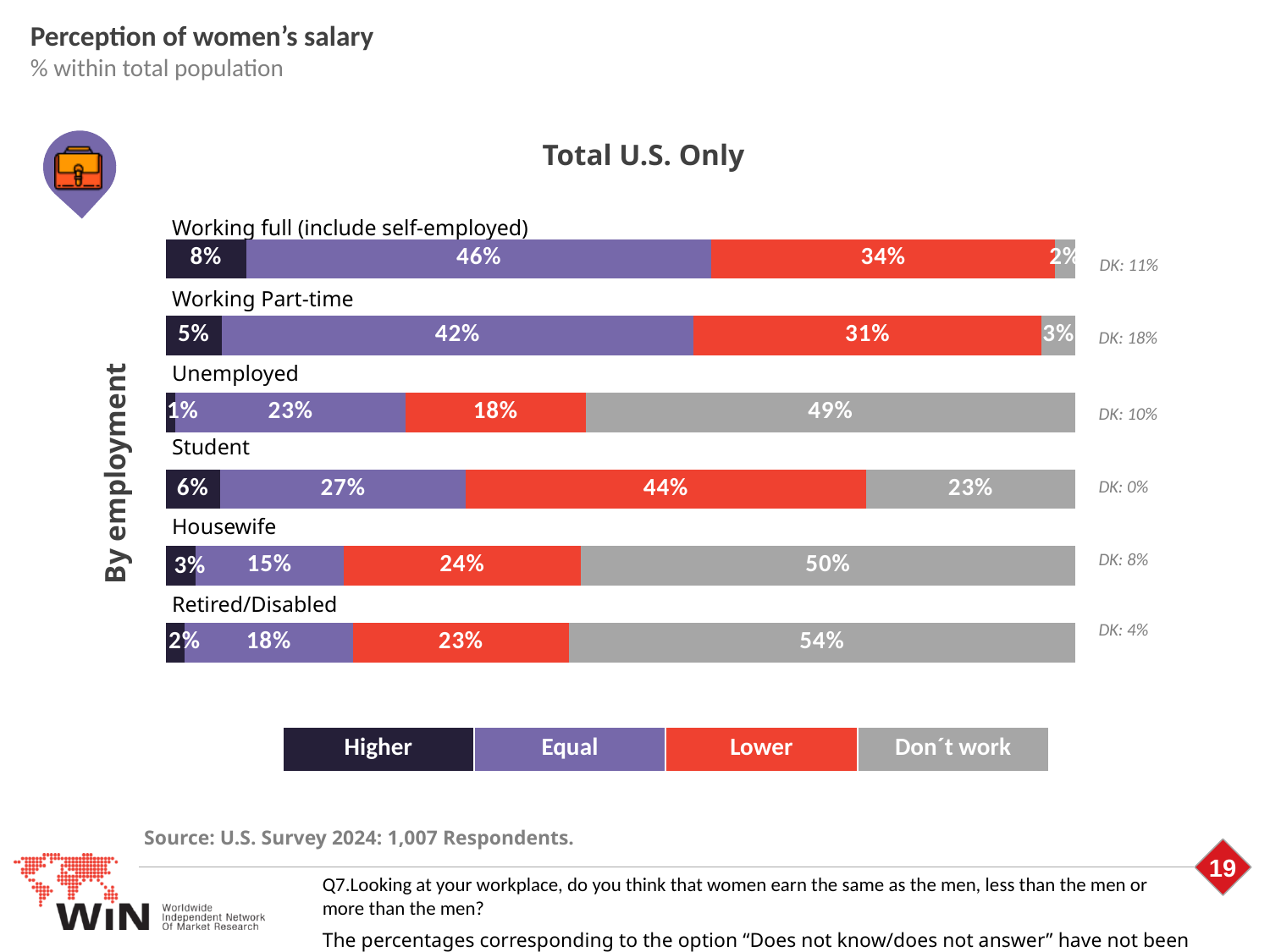
What is the difference between the Lower value for Working full (include self-employed) and the Lower value for Working Part-time? 3 percentage points Which employment category has the highest Higher value? Working full (include self-employed) Which employment category has the highest Don't work value? Retired/Disabled How many employment categories are shown in the chart? 6 What percentage of Working full (include self-employed) respondents said women's salary is Equal? 46% What is the DK value shown for the Working Part-time category? DK: 18% What is the Don't work value for the Retired/Disabled category? 54% What type of chart is shown on the slide? Stacked bar chart What percentage of Student respondents said women's salary is Lower? 44% Which employment category has the lowest Higher value? Unemployed Which has a larger Equal value, Working Part-time or Student? Working Part-time How many series does the legend list? 4